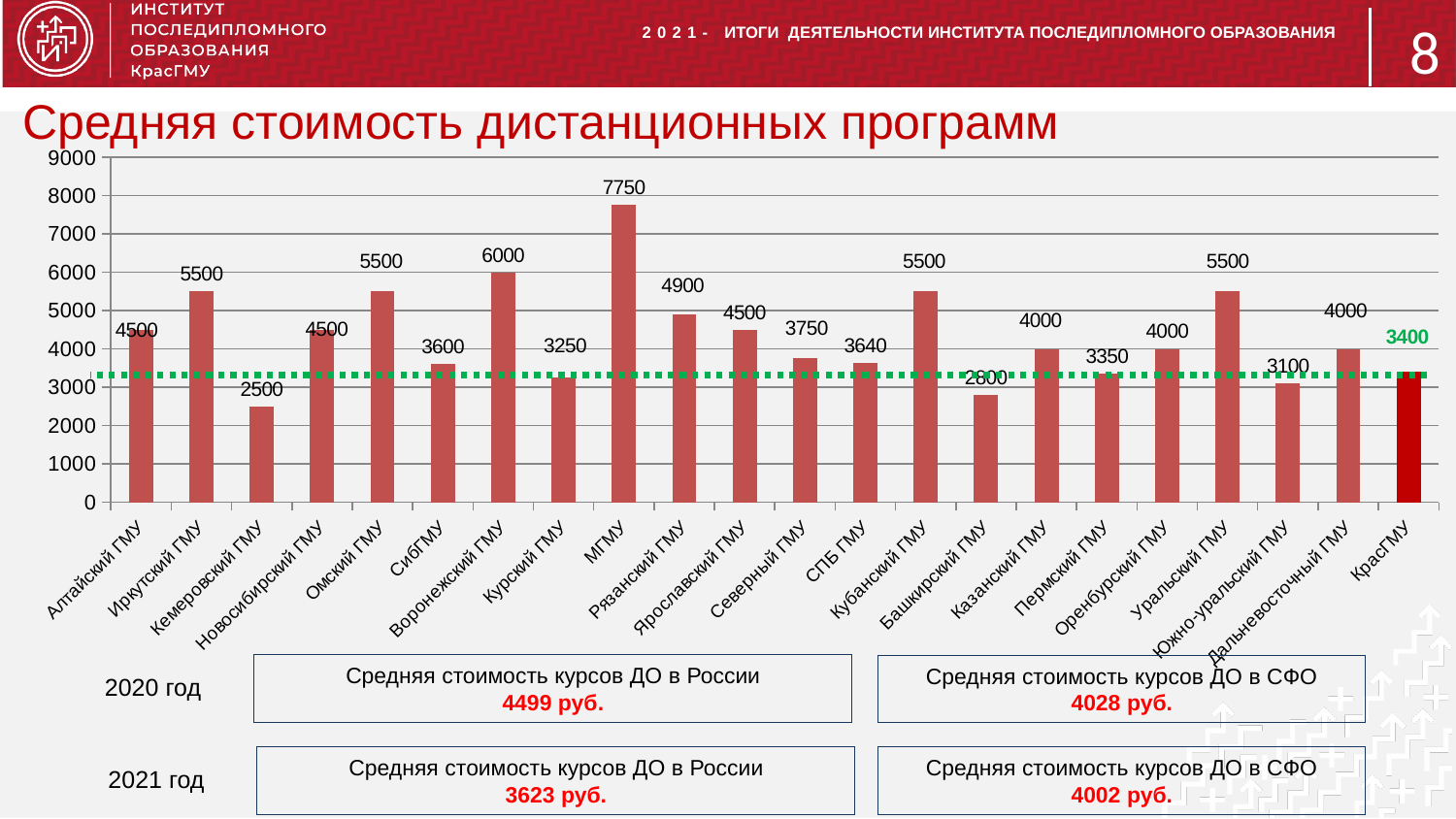
What is the value for СПБ ГМУ? 3640 What is the value for МГМУ? 7750 What is the value for Кемеровский ГМУ? 2500 What is the difference between the values for Воронежский ГМУ and Курский ГМУ? 2750 Which category has the lowest value? Кемеровский ГМУ What is the value for КрасГМУ? 3400 Is the value for Башкирский ГМУ greater or less than 3000? less Which is larger, the value for Рязанский ГМУ or the value for Северный ГМУ? Рязанский ГМУ Which category has the highest value? МГМУ How many categories are shown on the x axis? 22 What kind of chart is shown on the slide? bar chart What is the title of the chart? Средняя стоимость дистанционных программ